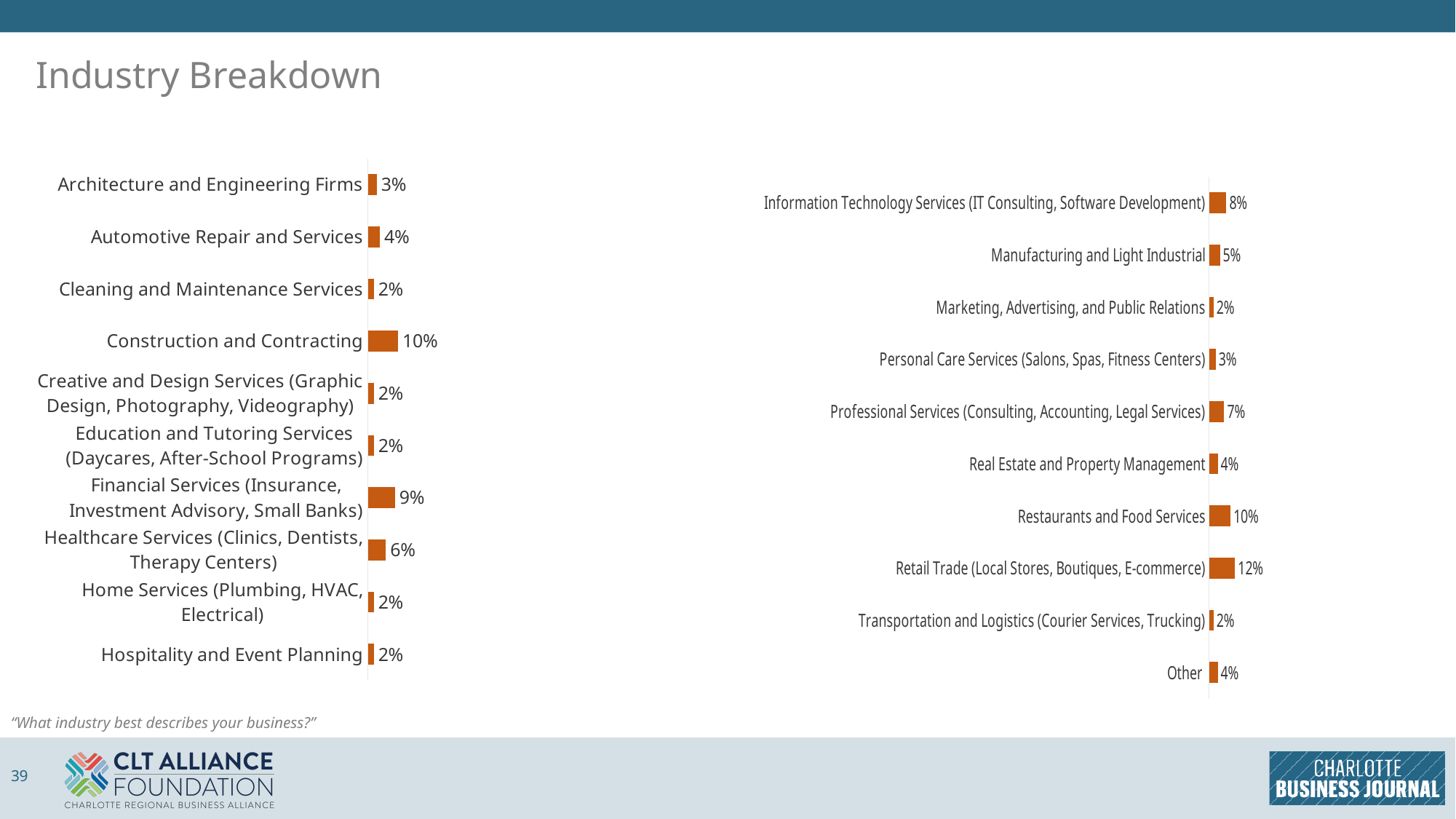
In the right chart, what is the value for Professional Services (Consulting, Accounting, Legal Services)? 7% How many categories are shown in the right chart? 10 In the right chart, which is larger: Information Technology Services or Manufacturing and Light Industrial? Information Technology Services In the right chart, which category has the highest value? Retail Trade (Local Stores, Boutiques, E-commerce) In the left chart, what is the value for Construction and Contracting? 10% What type of chart is the left chart? Bar chart In the right chart, what is the difference between Retail Trade and Restaurants and Food Services? 2% How many categories are shown in the left chart? 10 In the left chart, what is the value for Healthcare Services (Clinics, Dentists, Therapy Centers)? 6% In the left chart, which is larger: Automotive Repair and Services or Architecture and Engineering Firms? Automotive Repair and Services In the left chart, which category has the highest value? Construction and Contracting In the left chart, what is the difference between Construction and Contracting and Financial Services? 1%